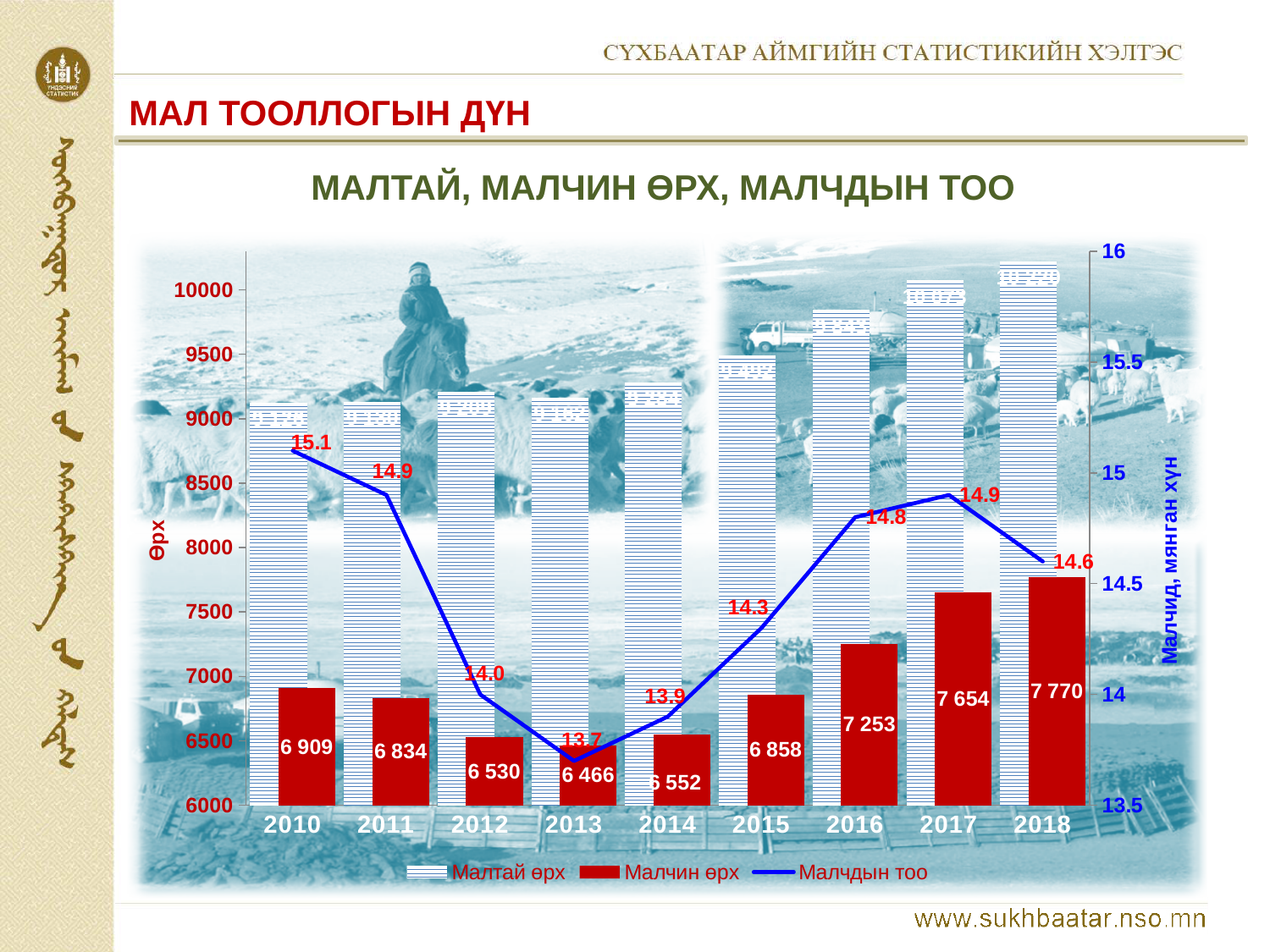
How many years are shown on the x axis? 9 What is the value of Малчдын тоо for 2013? 13.7 How many series does the legend list? 3 In which year is Малчин өрх highest? 2018 Does Малчин өрх rise or fall from 2013 to 2018? rise What is the difference between Малчин өрх in 2018 and in 2010? 861 In which year is Малчин өрх lowest? 2013 What is the value of Малчин өрх for 2018? 7 770 What is the value of Малчин өрх for 2012? 6 530 Which year has the larger Малчин өрх value, 2011 or 2015? 2015 In which year is Малчдын тоо highest? 2010 Is the value of Малтай өрх for 2018 greater or less than 10000? greater